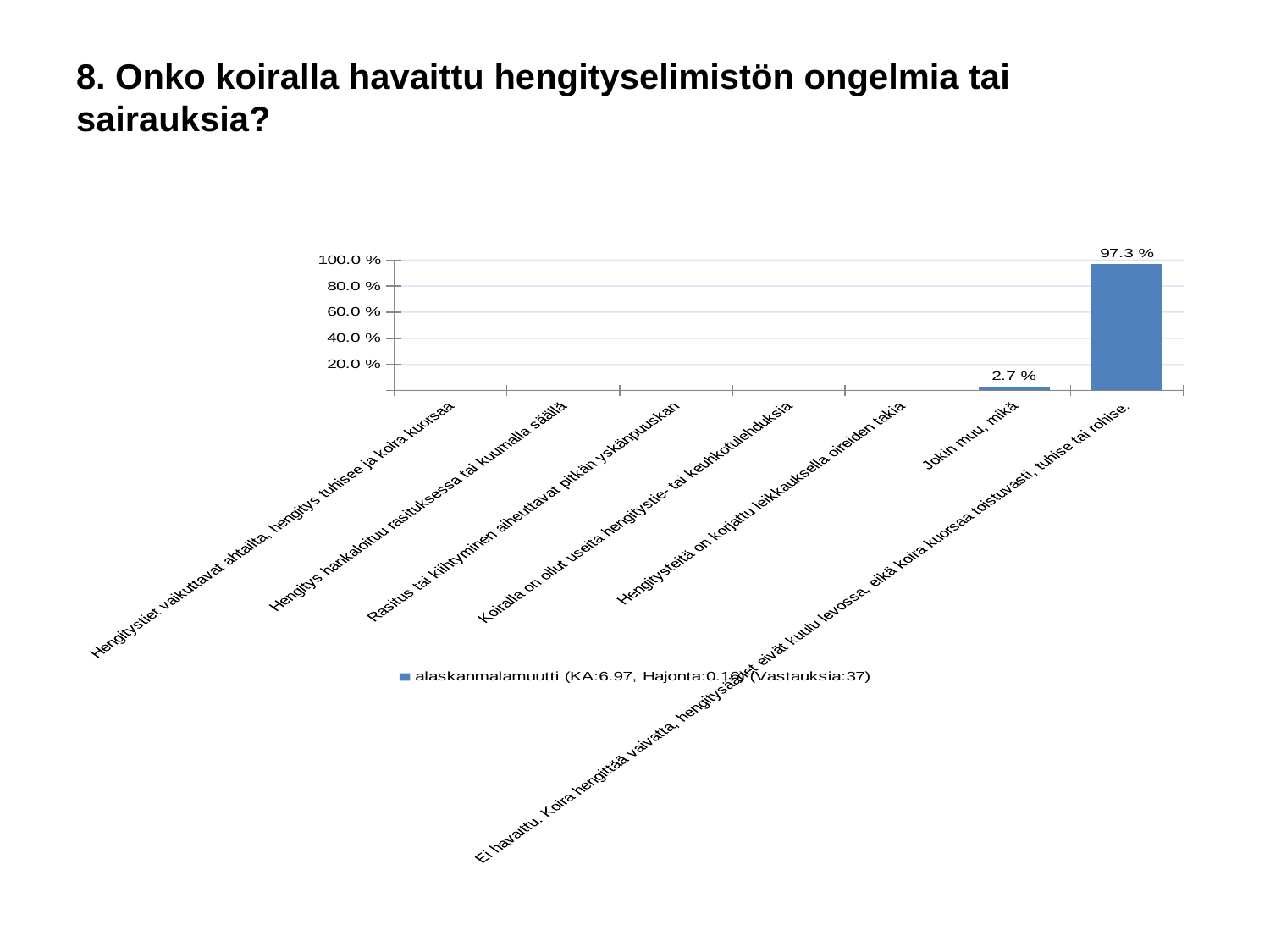
How many categories are shown on the x axis? 7 What is the title of the slide? 8. Onko koiralla havaittu hengityselimistön ongelmia tai sairauksia? Which is larger, the value for "Jokin muu, mikä" or the value for "Ei havaittu..."? Ei havaittu... What is the legend entry of the chart? alaskanmalamuutti (KA:6.97, Hajonta:0.16) (Vastauksia:37) What is the difference between the values for "Ei havaittu..." and "Jokin muu, mikä"? 94.6 % Which category has the highest value? Ei havaittu. Koira hengittää vaivatta, hengitysäänet eivät kuulu levossa, eikä koira kuorsaa toistuvasti, tuhise tai rohise. Is the value for "Ei havaittu..." greater or less than 80.0 %? greater Is the value for "Jokin muu, mikä" greater or less than 20.0 %? less What kind of chart is shown on the slide? bar chart What is the value for "Jokin muu, mikä"? 2.7 % How many series does the legend list? 1 What is the value for the category "Ei havaittu. Koira hengittää vaivatta..."? 97.3 %